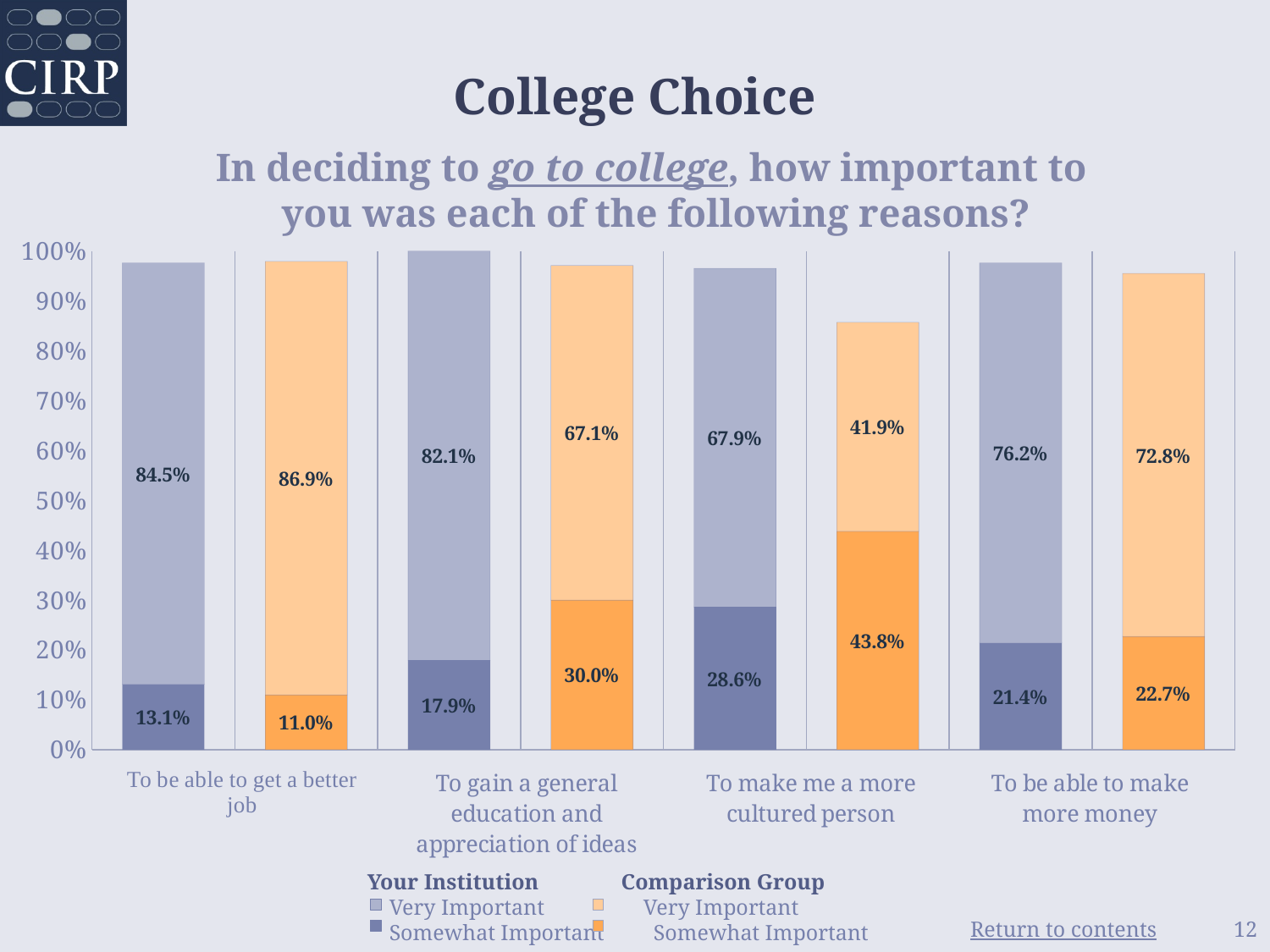
What is the difference between the Comparison Group's and Your Institution's Very Important values for 'To gain a general education and appreciation of ideas'? 15.0% What is the total of Your Institution's stacked bar for 'To be able to make more money'? 97.6% Which reason has the lowest Very Important percentage for the Comparison Group? To make me a more cultured person How many series does the legend list? 4 What kind of chart is shown on the slide? stacked bar chart What is the total of the Comparison Group's stacked bar for 'To make me a more cultured person'? 85.7% What percentage of the Comparison Group rated 'To make me a more cultured person' as Somewhat Important? 43.8% How many reasons (categories) are shown along the x axis? 4 What is the Comparison Group's Very Important value for 'To be able to make more money'? 72.8% For 'To make me a more cultured person', which is larger: Your Institution's Very Important value or the Comparison Group's Very Important value? Your Institution What percentage of Your Institution respondents rated 'To be able to get a better job' as Very Important? 84.5% Which reason has the highest Very Important percentage for Your Institution? To be able to get a better job